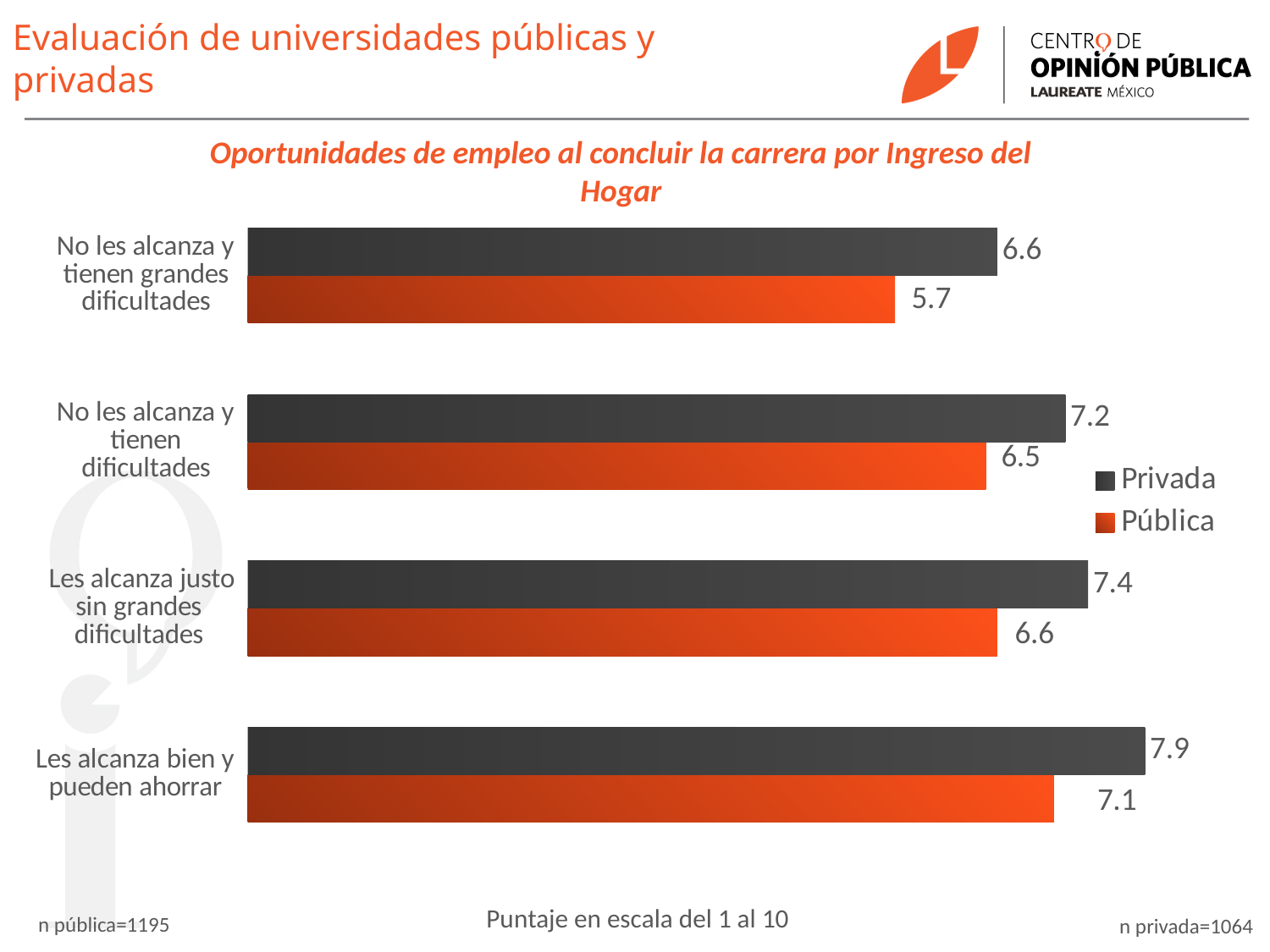
What is the Pública value for "No les alcanza y tienen grandes dificultades"? 5.7 What kind of chart is shown on the slide? Bar chart Which category has the lowest Pública value? No les alcanza y tienen grandes dificultades What is the Privada value for "Les alcanza bien y pueden ahorrar"? 7.9 Which series is shown in orange in the legend? Pública What is the difference between the Privada and Pública values for "Les alcanza bien y pueden ahorrar"? 0.8 What is the Pública value for "Les alcanza justo sin grandes dificultades"? 6.6 For "No les alcanza y tienen dificultades", which is larger, the Privada or the Pública value? Privada How many categories are shown on the chart? 4 Which category has the highest Privada value? Les alcanza bien y pueden ahorrar What is the difference between the Privada and Pública values for "No les alcanza y tienen grandes dificultades"? 0.9 How many series does the legend list? 2